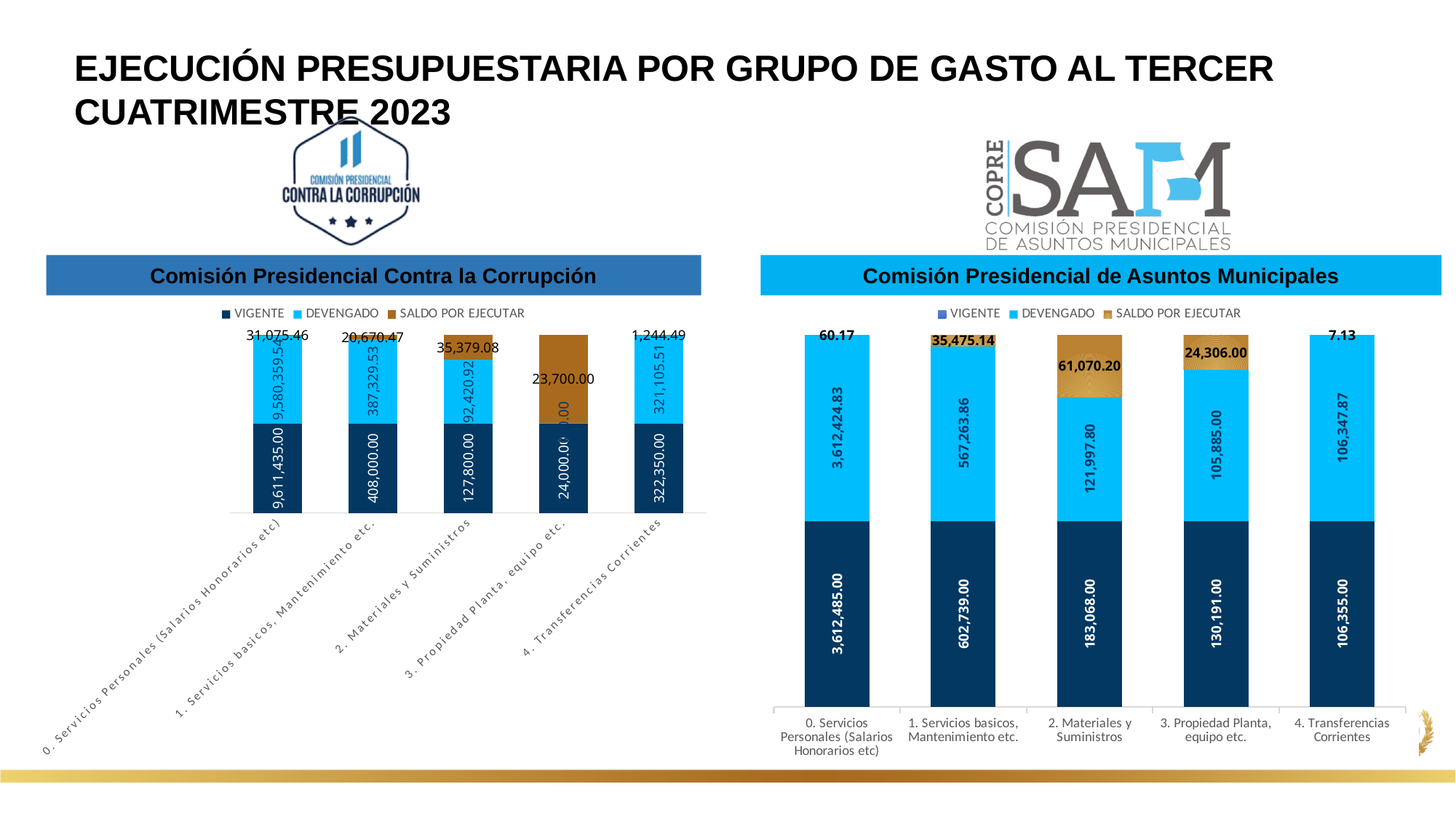
In the Comisión Presidencial de Asuntos Municipales chart, what is the SALDO POR EJECUTAR value for 2. Materiales y Suministros? 61,070.20 In the Comisión Presidencial de Asuntos Municipales chart, which category has the highest SALDO POR EJECUTAR value? 2. Materiales y Suministros What kind of chart is the Comisión Presidencial Contra la Corrupción chart? Stacked bar chart In the Comisión Presidencial de Asuntos Municipales chart, what is the difference between the VIGENTE and DEVENGADO values for 1. Servicios basicos, Mantenimiento etc.? 35,475.14 In the Comisión Presidencial de Asuntos Municipales chart, which category has the lowest SALDO POR EJECUTAR value? 4. Transferencias Corrientes In the Comisión Presidencial Contra la Corrupción chart, what is the SALDO POR EJECUTAR value for 3. Propiedad Planta, equipo etc.? 23,700.00 In the Comisión Presidencial Contra la Corrupción chart, what is the VIGENTE value for 1. Servicios basicos, Mantenimiento etc.? 408,000.00 In the Comisión Presidencial Contra la Corrupción chart, which is larger: the SALDO POR EJECUTAR for 2. Materiales y Suministros or for 1. Servicios basicos, Mantenimiento etc.? 2. Materiales y Suministros In the Comisión Presidencial Contra la Corrupción chart, what is the DEVENGADO value for 4. Transferencias Corrientes? 321,105.51 In the Comisión Presidencial de Asuntos Municipales chart, what is the VIGENTE value for 0. Servicios Personales (Salarios Honorarios etc)? 3,612,485.00 How many series does the legend of the Comisión Presidencial de Asuntos Municipales chart list? 3 In the Comisión Presidencial de Asuntos Municipales chart, what is the DEVENGADO value for 4. Transferencias Corrientes? 106,347.87